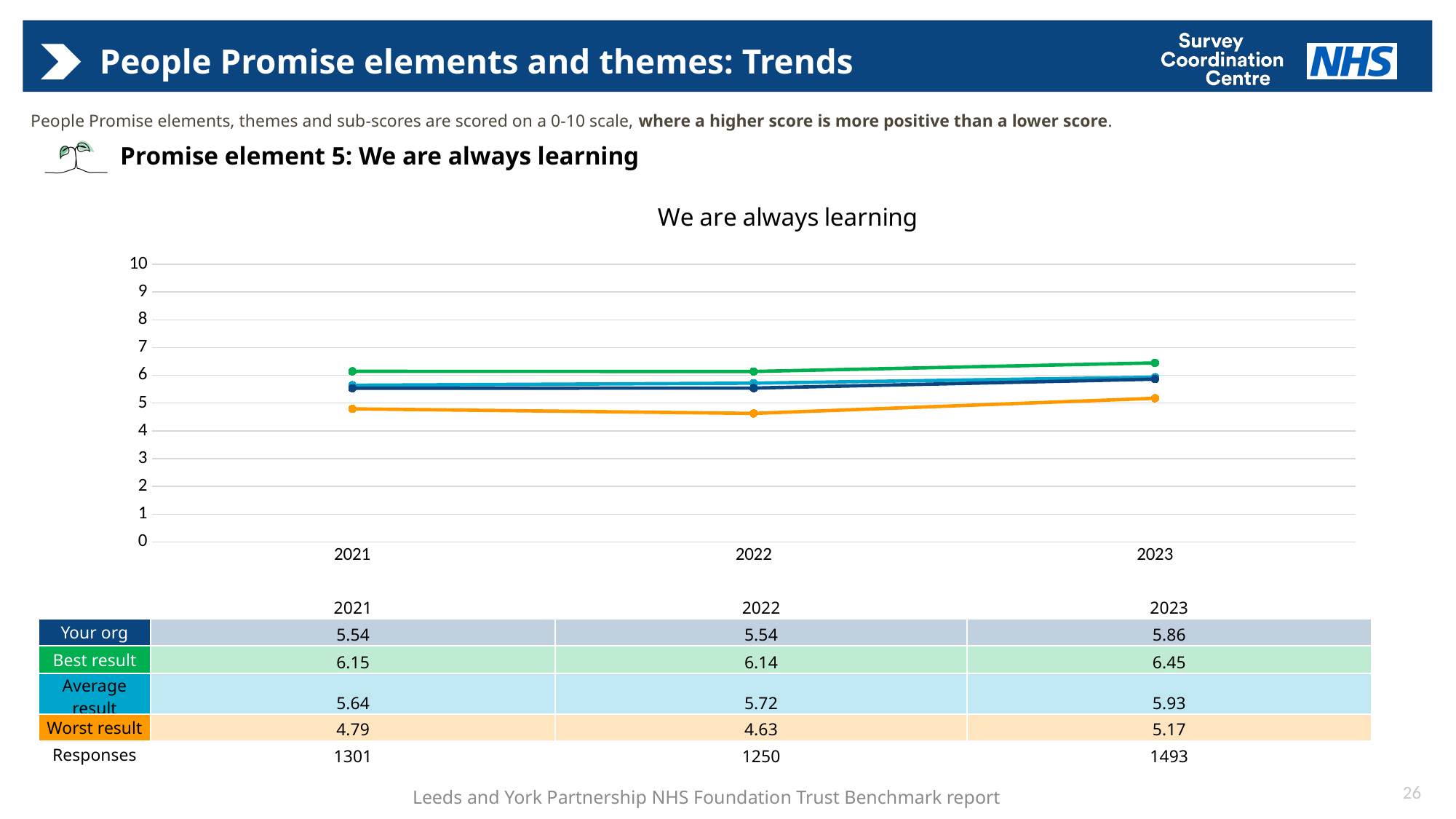
What type of chart is 'We are always learning'? Line chart Is the 'Worst result' value for 2022 in the 'We are always learning' chart greater or less than 5? less What is the 'Your org' score for 2023 in the 'We are always learning' chart? 5.86 What is the 'Best result' score for 2021 in the 'We are always learning' chart? 6.15 In which year is the 'Best result' score highest in the 'We are always learning' chart? 2023 How many series are shown in the 'We are always learning' chart? 4 What is the 'Worst result' score for 2022 in the 'We are always learning' chart? 4.63 How many years are plotted on the x axis of the 'We are always learning' chart? 3 Which is larger in 2021 in the 'We are always learning' chart: the 'Your org' score or the 'Average result' score? Average result What is the difference between the 'Best result' and 'Worst result' scores for 2023 in the 'We are always learning' chart? 1.28 What is the 'Average result' score for 2022 in the 'We are always learning' chart? 5.72 In which year is the 'Worst result' score lowest in the 'We are always learning' chart? 2022